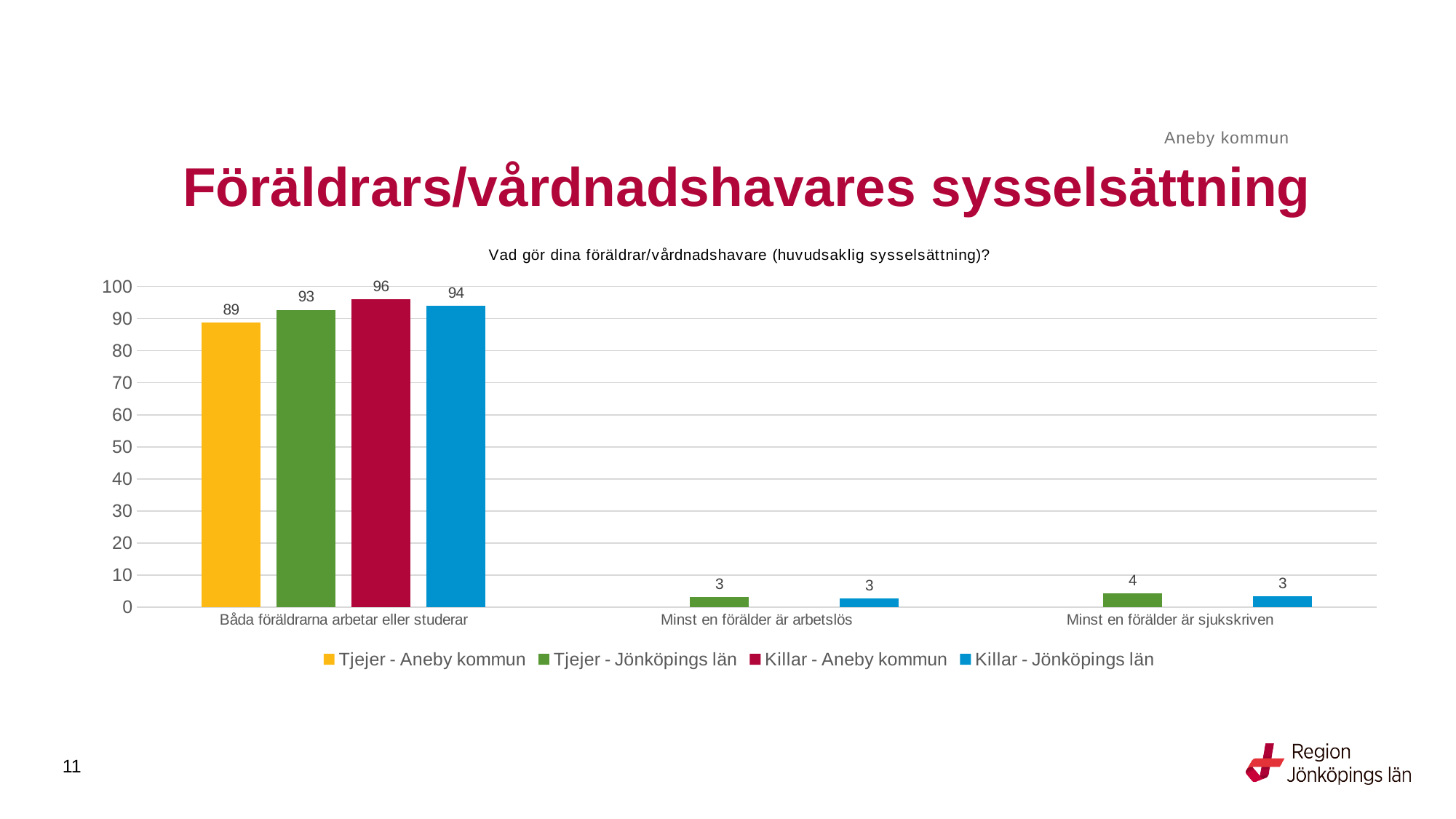
What is the value for Killar - Jönköpings län in the category 'Minst en förälder är arbetslös'? 3 How many categories are shown on the x axis? 3 What kind of chart is shown on the slide? Bar chart Which series has the lowest value in the category 'Båda föräldrarna arbetar eller studerar'? Tjejer - Aneby kommun How many series does the legend list? 4 What is the value for Killar - Aneby kommun in the category 'Båda föräldrarna arbetar eller studerar'? 96 Which series has the highest value in the category 'Båda föräldrarna arbetar eller studerar'? Killar - Aneby kommun What colour represents Killar - Jönköpings län in the legend? Blue What is the value for Tjejer - Jönköpings län in the category 'Minst en förälder är sjukskriven'? 4 What is the difference between Killar - Aneby kommun and Tjejer - Aneby kommun in the category 'Båda föräldrarna arbetar eller studerar'? 7 What is the value for Tjejer - Aneby kommun in the category 'Båda föräldrarna arbetar eller studerar'? 89 Which is larger in the category 'Båda föräldrarna arbetar eller studerar': Tjejer - Jönköpings län or Killar - Jönköpings län? Killar - Jönköpings län